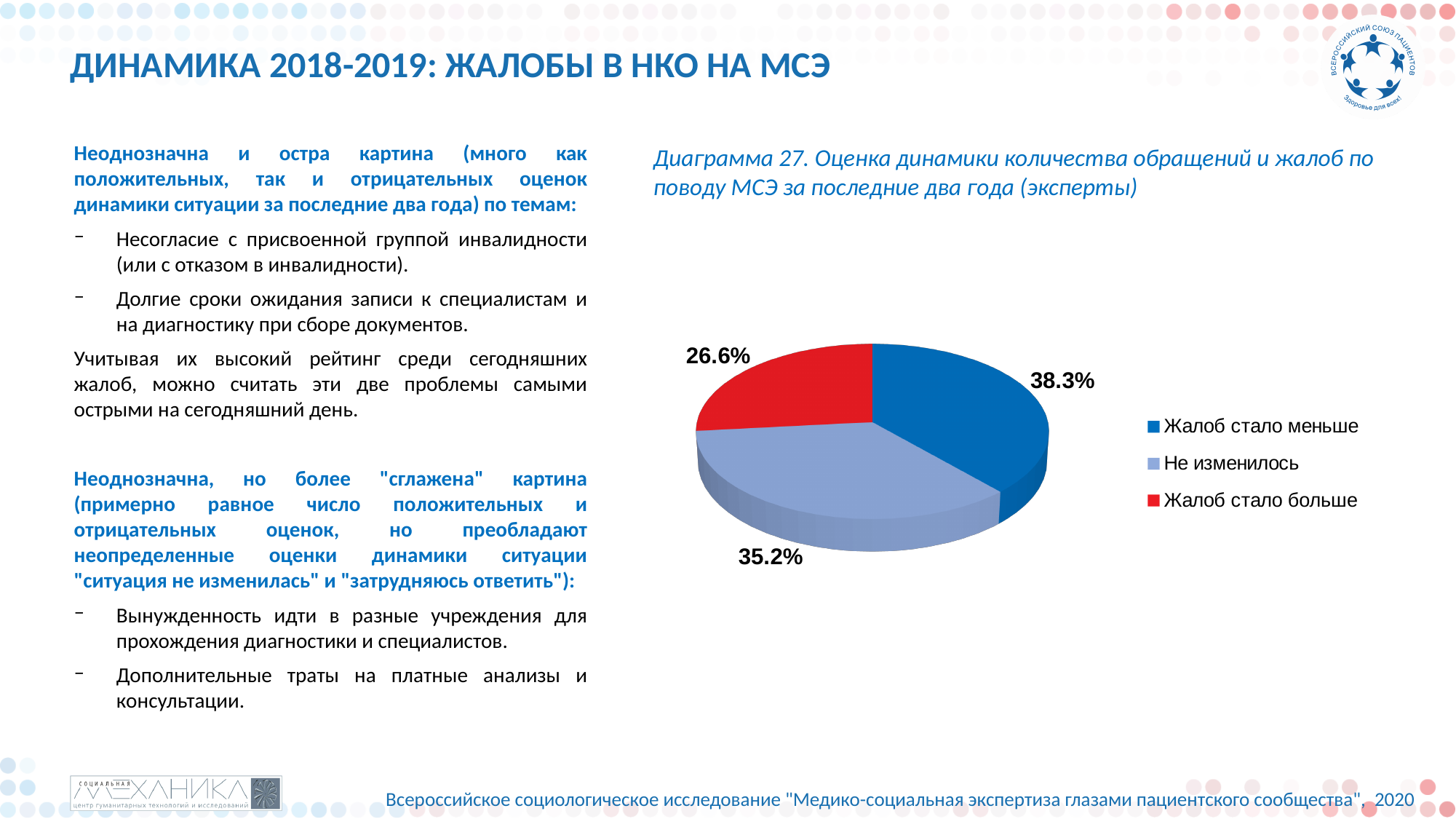
What share of the pie corresponds to "Не изменилось"? 35.2% What is the difference between the shares for "Жалоб стало меньше" and "Жалоб стало больше"? 11.7% What is the difference between the shares for "Не изменилось" and "Жалоб стало больше"? 8.6% How many entries does the legend list? 3 Which colour represents "Жалоб стало больше" in the pie chart? Red What share of the pie corresponds to "Жалоб стало больше"? 26.6% Which is larger: the share for "Жалоб стало меньше" or the share for "Не изменилось"? Жалоб стало меньше What share of the pie corresponds to "Жалоб стало меньше"? 38.3% What type of chart is shown on the slide? Pie chart Which category has the smallest slice of the pie? Жалоб стало больше How many slices does the pie chart have? 3 Which category has the largest slice of the pie? Жалоб стало меньше